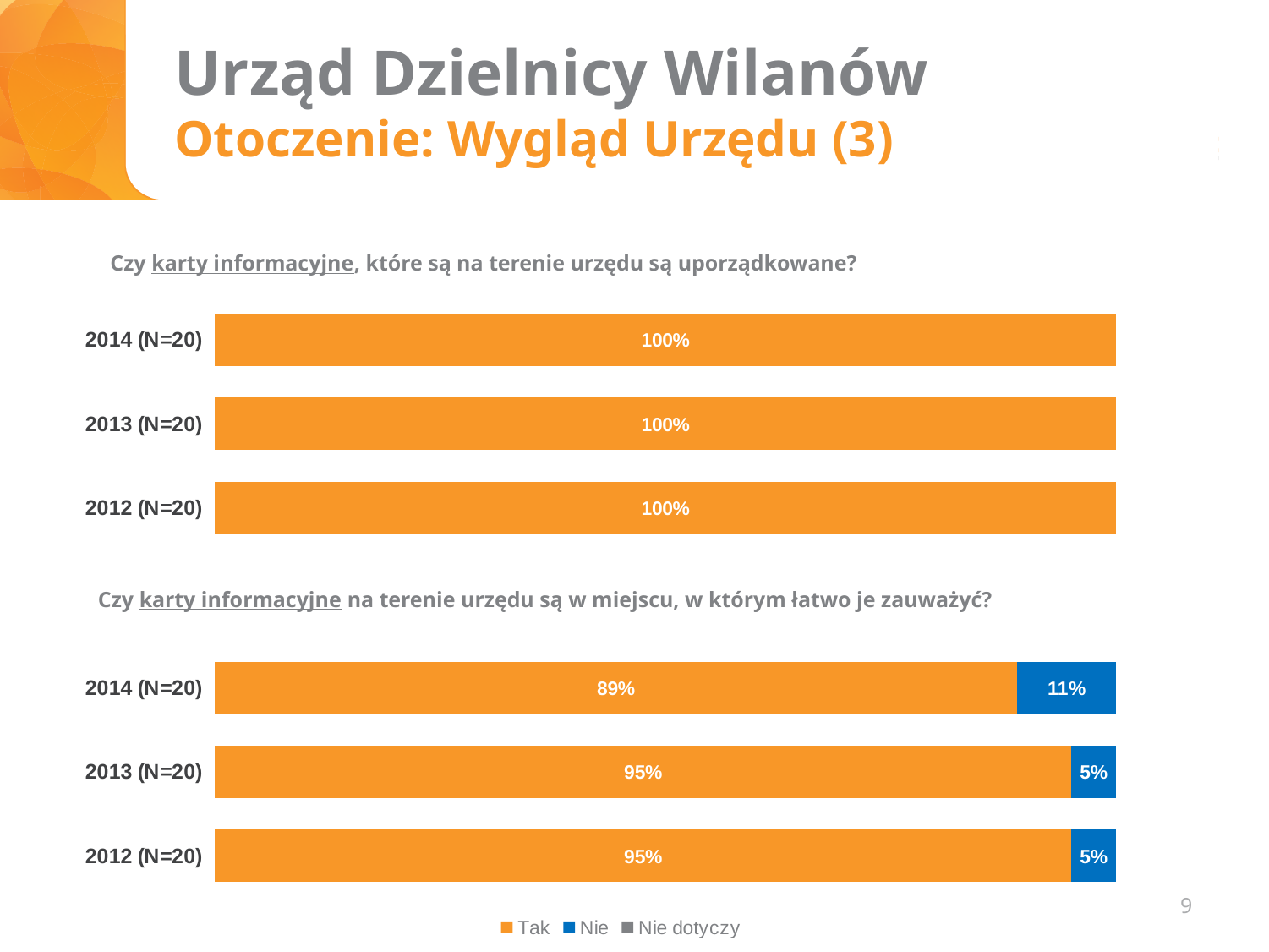
In the bottom chart ("Czy karty informacyjne na terenie urzędu są w miejscu, w którym łatwo je zauważyć?"), what is the "Tak" value for 2013 (N=20)? 95% How many series does the legend at the bottom of the slide list? 3 How many year categories does the top chart ("Czy karty informacyjne, które są na terenie urzędu są uporządkowane?") show? 3 What type of chart is the bottom chart ("Czy karty informacyjne na terenie urzędu są w miejscu, w którym łatwo je zauważyć?")? Stacked bar chart In the bottom chart ("Czy karty informacyjne na terenie urzędu są w miejscu, w którym łatwo je zauważyć?"), which year has the lowest "Tak" value? 2014 (N=20) In the bottom chart ("Czy karty informacyjne na terenie urzędu są w miejscu, w którym łatwo je zauważyć?"), is the "Nie" value larger for 2014 (N=20) or 2013 (N=20)? 2014 (N=20) In the top chart ("Czy karty informacyjne, które są na terenie urzędu są uporządkowane?"), what is the "Tak" value for 2012 (N=20)? 100% In the bottom chart ("Czy karty informacyjne na terenie urzędu są w miejscu, w którym łatwo je zauważyć?"), what is the "Tak" value for 2014 (N=20)? 89% In the bottom chart ("Czy karty informacyjne na terenie urzędu są w miejscu, w którym łatwo je zauważyć?"), which year has the highest "Nie" value? 2014 (N=20) In the bottom chart ("Czy karty informacyjne na terenie urzędu są w miejscu, w którym łatwo je zauważyć?"), what is the "Nie" value for 2014 (N=20)? 11% In the bottom chart ("Czy karty informacyjne na terenie urzędu są w miejscu, w którym łatwo je zauważyć?"), what is the "Nie" value for 2012 (N=20)? 5% In the bottom chart ("Czy karty informacyjne na terenie urzędu są w miejscu, w którym łatwo je zauważyć?"), what is the difference between the "Tak" values for 2013 (N=20) and 2014 (N=20)? 6%